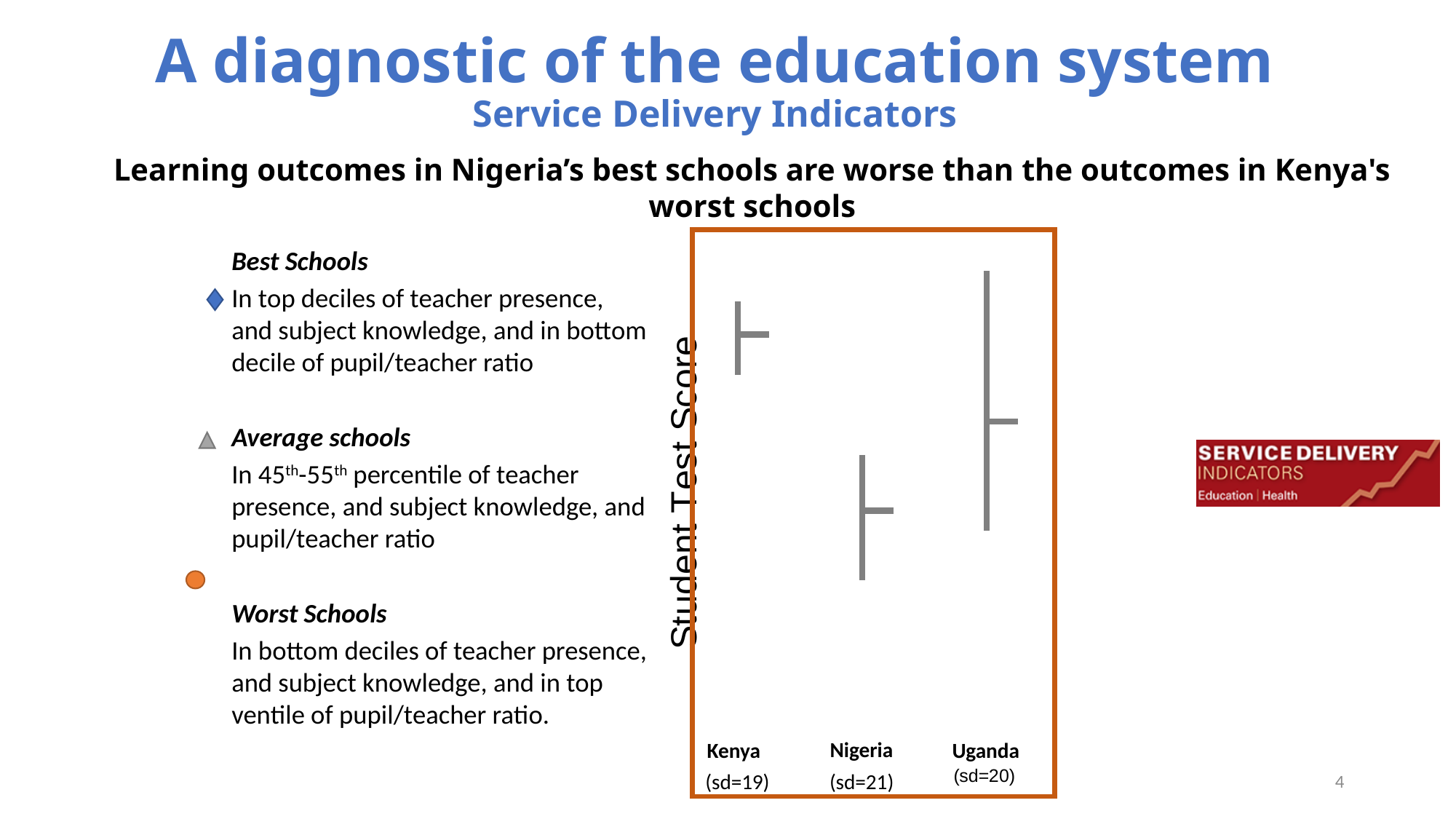
Which country has the largest printed standard deviation on the chart? Nigeria Is the average student test score marker higher for Uganda or for Nigeria? Uganda What is the label on the vertical axis of the chart? Student Test Score What standard deviation is printed for Uganda on the chart? sd=20 Which country has the lowest average student test score marker on the chart? Nigeria Which country's vertical range bar spans the narrowest range of student test scores? Kenya Which country has the highest average student test score marker on the chart? Kenya Which country's vertical range bar spans the widest range of student test scores? Uganda What standard deviation is printed for Kenya on the chart? sd=19 How many countries are shown on the chart? 3 What standard deviation is printed for Nigeria on the chart? sd=21 Is the average student test score marker higher for Kenya or for Nigeria? Kenya